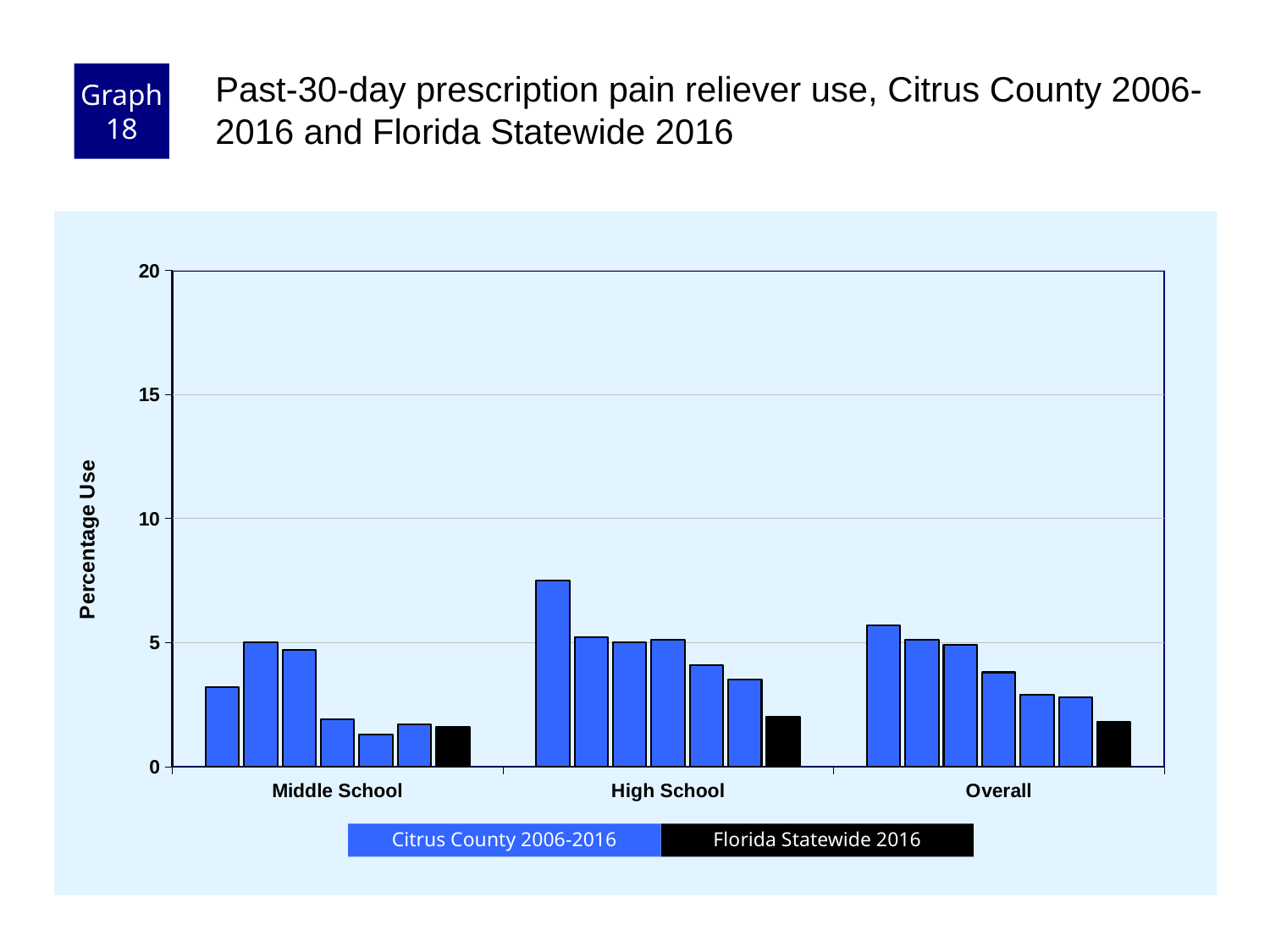
What kind of chart is shown on the slide? bar chart How many series does the legend list? 2 Is the Florida Statewide 2016 value for Middle School greater or less than 5? less Within the Overall category, do the Citrus County 2006-2016 bars generally rise or fall from left to right? fall Which is larger: the tallest Citrus County 2006-2016 bar for High School or the tallest Citrus County 2006-2016 bar for Middle School? High School Which category contains the tallest bar in the chart? High School Which colour represents Florida Statewide 2016 in the legend? black What is the label on the y axis? Percentage Use Is the tallest Citrus County 2006-2016 bar for High School greater or less than 5? greater How many school-level categories are shown on the x axis? 3 Is the Florida Statewide 2016 value for High School greater or less than 5? less